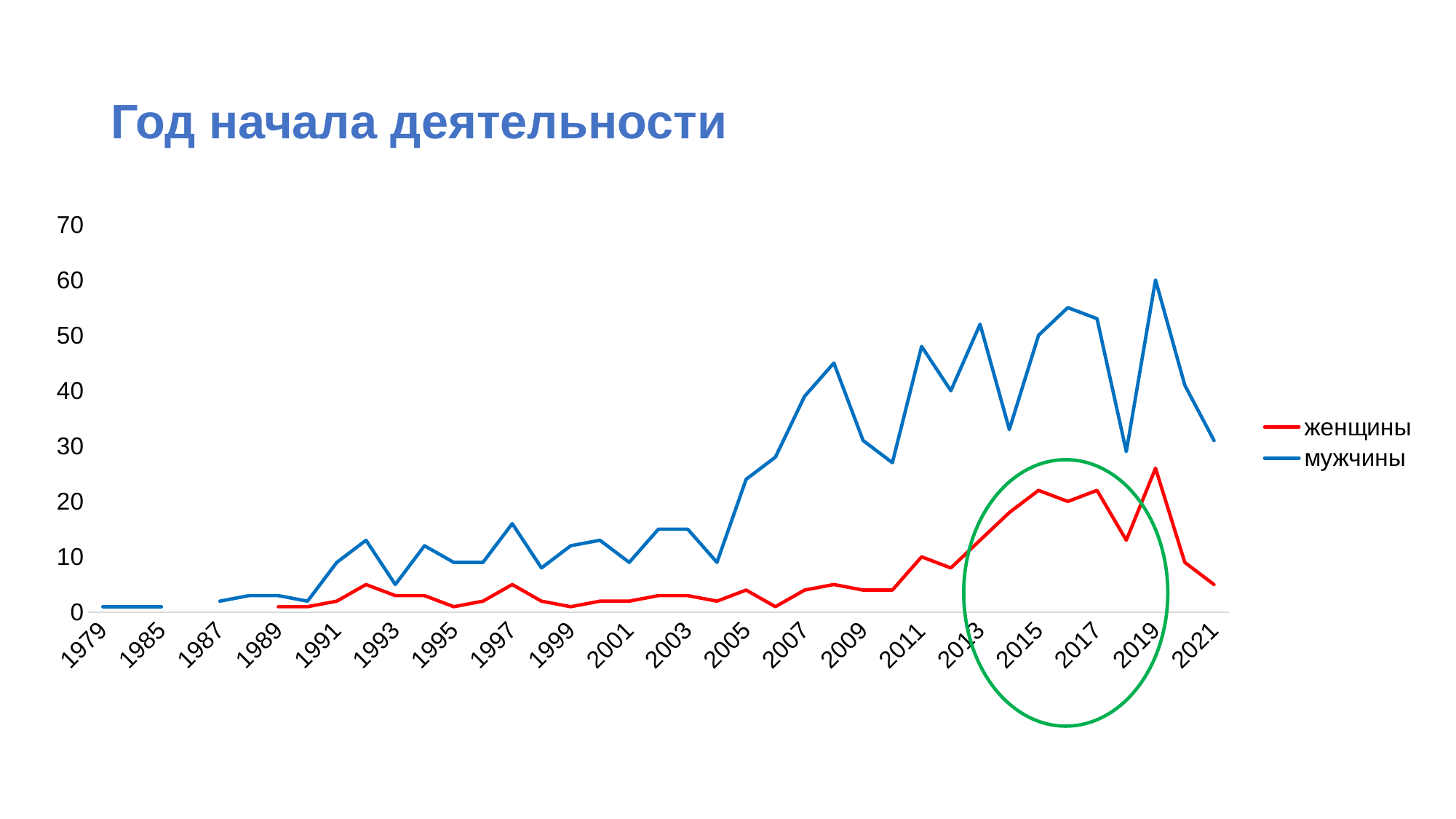
How many series does the legend list? 2 In which year does the мужчины series reach its highest value? 2019 Which colour is used for the женщины series? red Is the value for мужчины in 2021 greater or less than 40? less Is the value for женщины in 2021 greater or less than 10? less Is the value for женщины in 2019 greater or less than 20? greater What kind of chart is shown on the slide? line chart In which year does the женщины series reach its highest value? 2019 In 2019, which series has the higher value, женщины or мужчины? мужчины What is the title of the chart? Год начала деятельности Does the мужчины series rise or fall from 2019 to 2021? fall